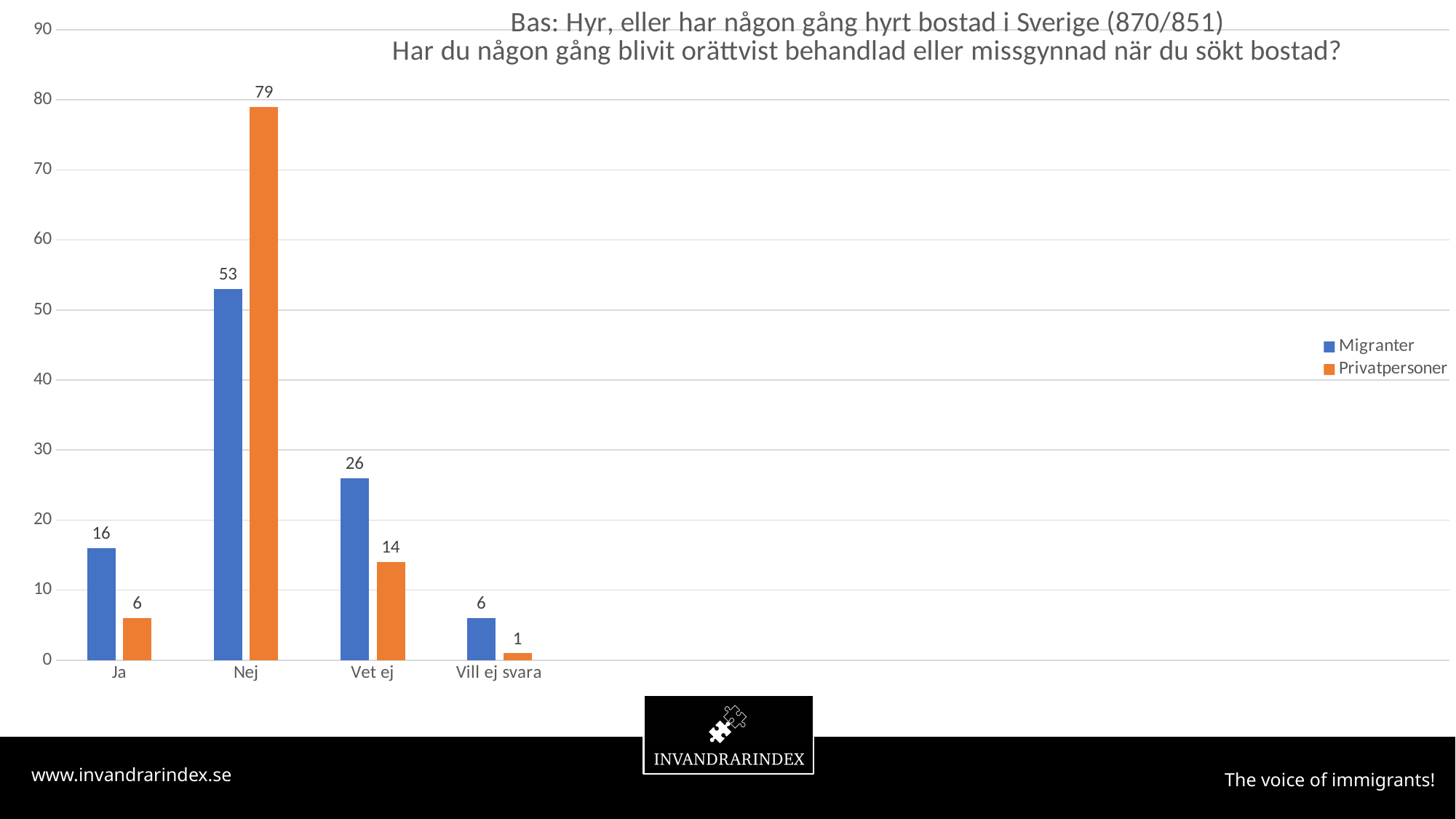
What is the value for Migranter in the Nej category? 53 Which category has the highest value for Privatpersoner? Nej Which colour represents the Privatpersoner series? Orange How many series does the legend list? 2 Which category has the lowest value for Migranter? Vill ej svara What is the value for Privatpersoner in the Ja category? 6 How many categories are shown on the x axis? 4 Is the value for Migranter in the Vet ej category greater or less than 20? greater What kind of chart is shown on the slide? Bar chart Which is larger in the Ja category, Migranter or Privatpersoner? Migranter What is the value for Privatpersoner in the Vet ej category? 14 What is the difference between the Privatpersoner and Migranter values in the Nej category? 26